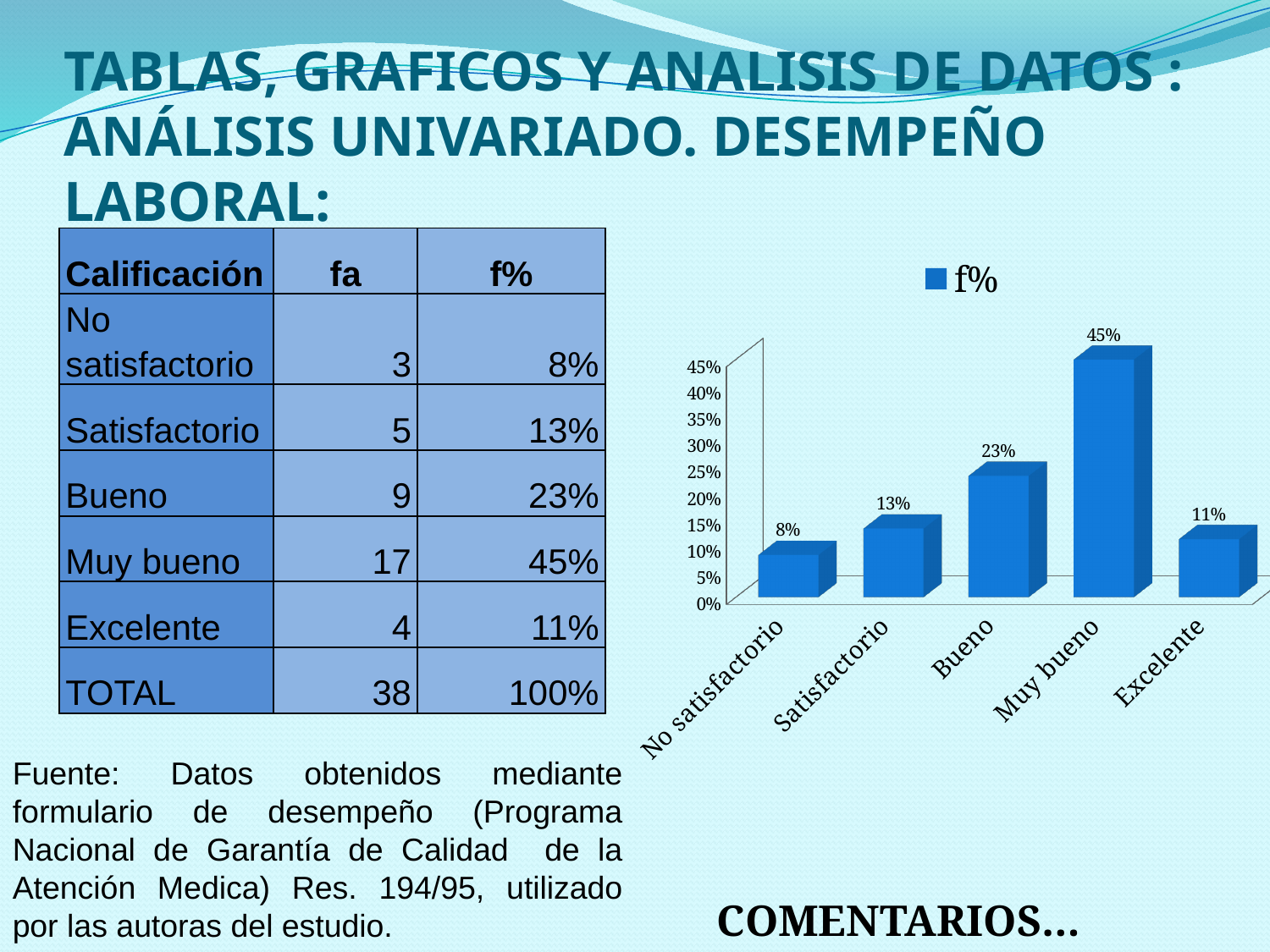
Which is larger, the value for Satisfactorio or the value for Excelente? Satisfactorio What is the name of the series shown in the chart legend? f% What is the difference between the values for Muy bueno and Bueno? 22% Which category has the lowest value in the chart? No satisfactorio What is the value for No satisfactorio in the chart? 8% What is the value for Muy bueno in the chart? 45% How many categories are shown on the x axis of the chart? 5 How many series does the chart legend list? 1 What is the value for Bueno in the chart? 23% What kind of chart is shown on the slide? bar chart Is the value for Bueno greater or less than 20%? greater Which category has the highest value in the chart? Muy bueno